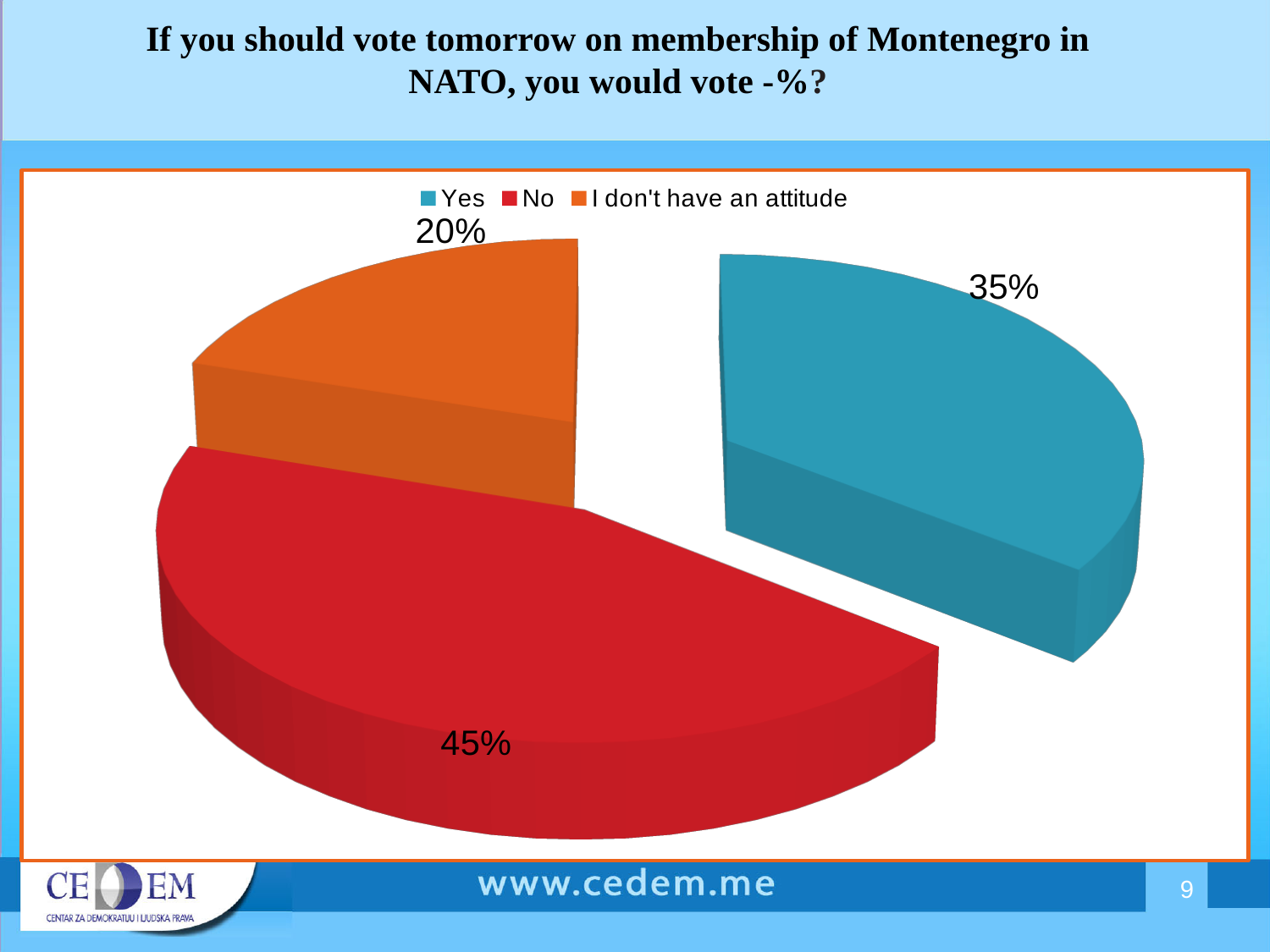
What is the difference in percentage points between "No" and "Yes"? 10 What percentage of respondents would vote "No"? 45% What colour is the "No" slice? Red What kind of chart is shown on the slide? Pie chart Which is larger, the share for "Yes" or the share for "I don't have an attitude"? Yes How many entries does the legend list? 3 What is the combined share of "Yes" and "No"? 80% How many slices does the pie chart have? 3 What percentage of respondents answered "I don't have an attitude"? 20% Which response has the smallest share of the pie? I don't have an attitude Which response has the largest share of the pie? No What percentage of respondents would vote "Yes"? 35%